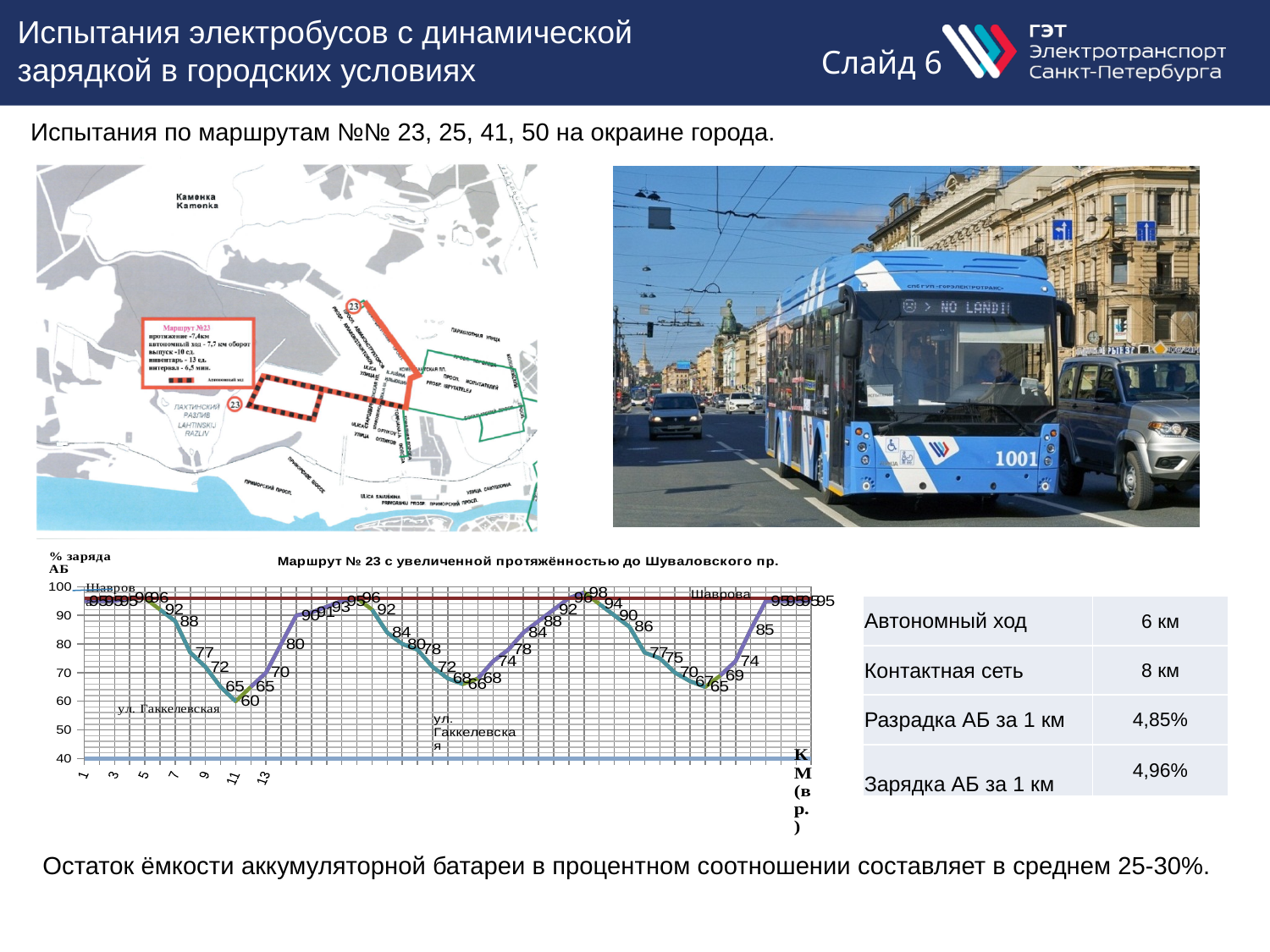
Is the charge value at the start of the route greater or less than 90? greater Which is lower: the first dip of the line (labeled 60) or the last dip (labeled 65)? the first dip (60) What is the charge value labeled at the end of the route on the chart? 95 What is the label of the vertical axis of the chart? % заряда АБ Is the lowest plotted charge value on the chart greater or less than 70? less From the start of the route to the first low point, do the charge values rise or fall? fall What is the title of the chart at the bottom left of the slide? Маршрут № 23 с увеличенной протяжённостью до Шуваловского пр. What is the lowest charge value labeled on the chart? 60 What is the highest charge value labeled on the chart? 98 What is the lowest value shown on the vertical axis of the chart? 40 What is the difference between the highest labeled value (98) and the lowest labeled value (60) on the chart? 38 What kind of chart is shown at the bottom left of the slide? line chart